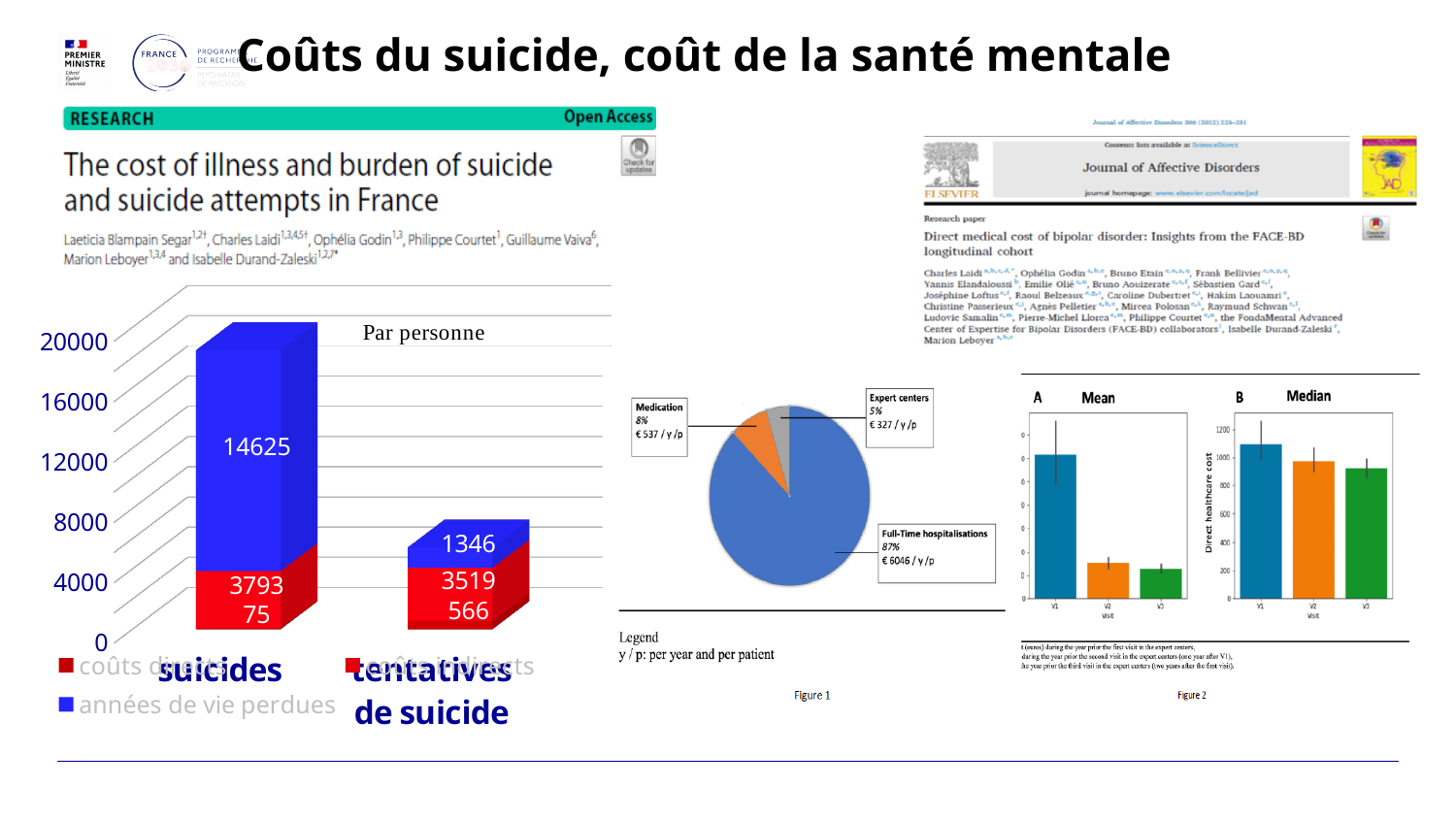
In the 'Par personne' stacked bar chart, what is the difference between the 'années de vie perdues' values for 'suicides' and 'tentatives de suicide'? 13279 In the 'Par personne' stacked bar chart, what is the total of the stacked bar for 'suicides'? 18493 In the 'Par personne' stacked bar chart, how many categories are shown on the x axis? 2 In the pie chart of Figure 1, which slice is the smallest? Expert centers In the pie chart of Figure 1, what share does 'Full-Time hospitalisations' represent? 87% In the pie chart of Figure 1, what is the cost per year and per patient for 'Medication'? € 537 / y /p In the 'Median' bar chart of Figure 2, is the value for V1 greater or less than 1000? greater In the 'Mean' bar chart of Figure 2, which visit has the highest direct healthcare cost? V1 In the 'Par personne' stacked bar chart, what is the value of the red 'coûts directs' segment for 'tentatives de suicide'? 566 In the 'Par personne' stacked bar chart, what is the value of the blue 'années de vie perdues' segment for 'suicides'? 14625 In the 'Par personne' stacked bar chart, how many series does the legend list? 3 In the 'Par personne' stacked bar chart, what is the total of the stacked bar for 'tentatives de suicide'? 5431